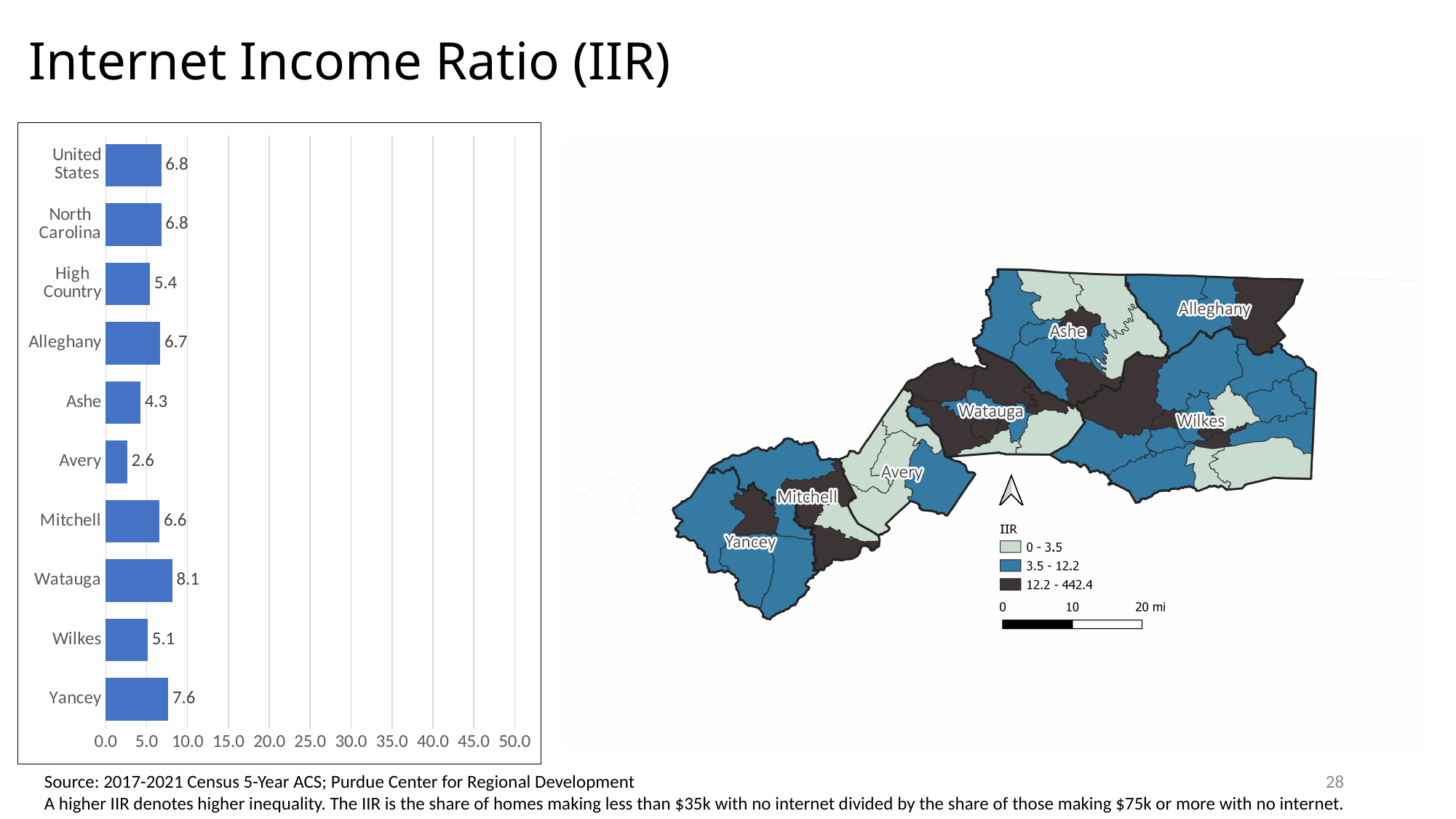
In the bar chart, what is the value for High Country? 5.4 In the bar chart, what is the value shown for Avery? 2.6 How many categories are shown in the bar chart? 10 In the bar chart, what is the difference between the values for United States and High Country? 1.4 In the bar chart, which has a larger value, Mitchell or Wilkes? Mitchell In the bar chart, which category has the highest value? Watauga In the bar chart, what is the IIR value for Watauga? 8.1 What type of chart is shown on the left of the slide? Bar chart In the bar chart, what is the value for Yancey? 7.6 In the bar chart, what is the difference between the values for Watauga and Avery? 5.5 What is the highest value shown on the x axis of the bar chart? 50.0 In the bar chart, which category has the lowest value? Avery